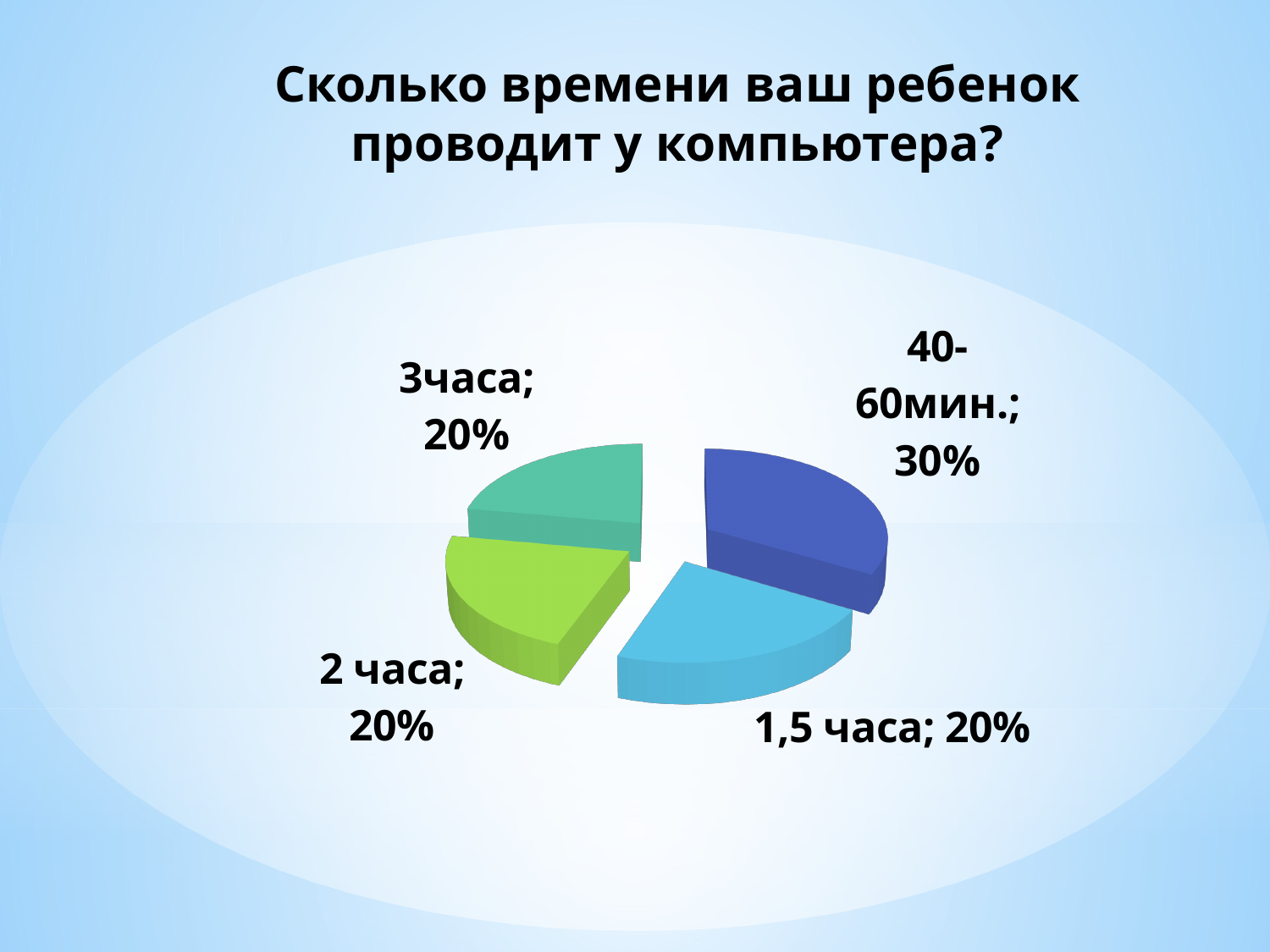
Which category has the largest share of the pie? 40-60мин. What percentage is shown for the "3часа" category? 20% What colour is the slice for "2 часа"? Green How many categories (slices) does the pie chart have? 4 What is the difference in percentage points between the "40-60мин." slice and the "2 часа" slice? 10% What type of chart is shown on the slide? Pie chart What share of the pie does the "40-60мин." slice represent? 30% What is the title of the chart? Сколько времени ваш ребенок проводит у компьютера? Which is larger: the share for "40-60мин." or the share for "1,5 часа"? 40-60мин. What percentage is shown for the "2 часа" category? 20% What percentage is shown for the "1,5 часа" category? 20% What is the combined share of the "1,5 часа", "2 часа" and "3часа" slices? 60%